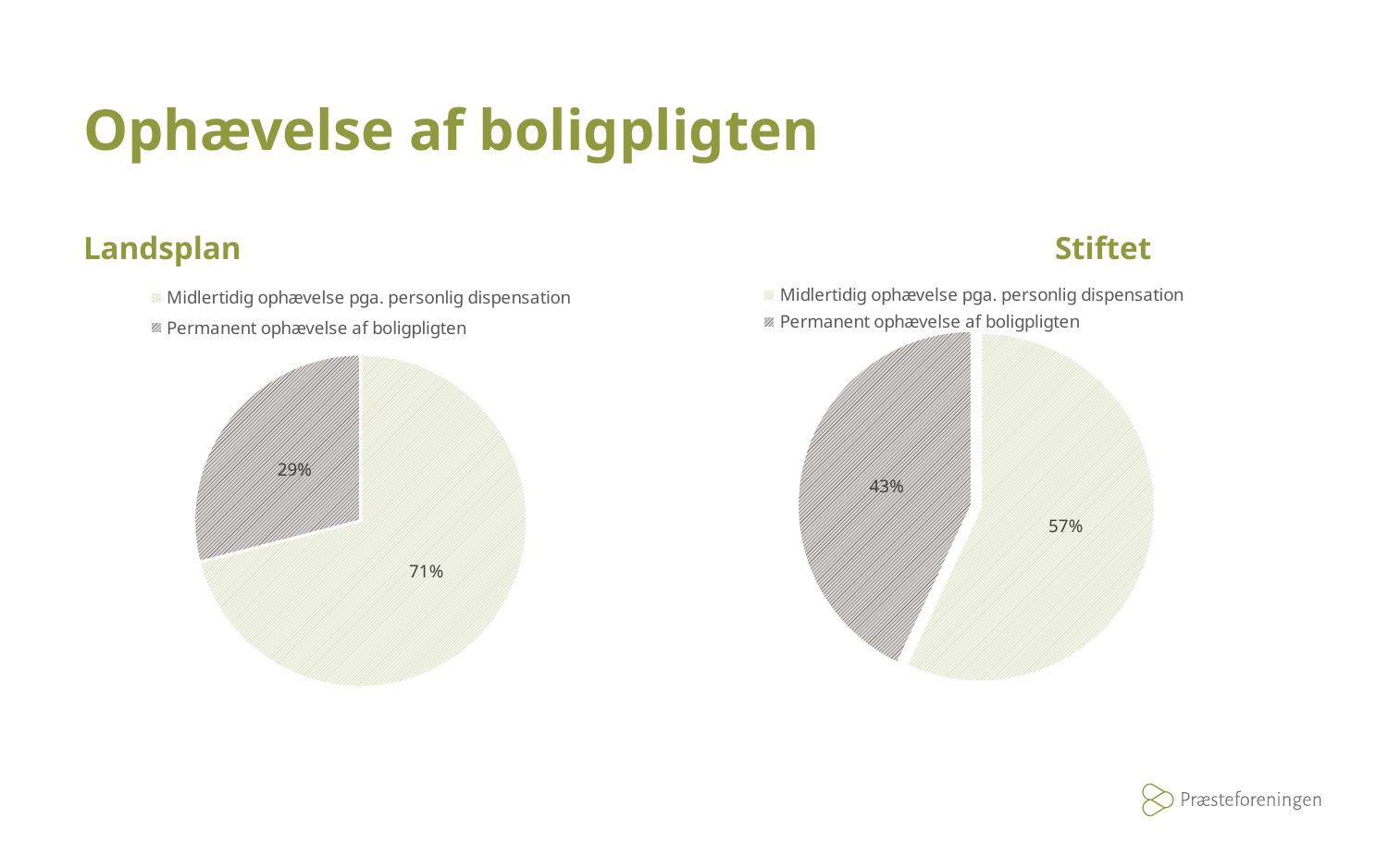
In the Landsplan chart, what is the difference in percentage points between the two slices? 42 In the Stiftet chart, what is the difference in percentage points between the two slices? 14 Is the share of Permanent ophævelse af boligpligten larger in the Landsplan chart or the Stiftet chart? Stiftet In the Landsplan chart, what share is Permanent ophævelse af boligpligten? 29% In the Stiftet chart, what share is Midlertidig ophævelse pga. personlig dispensation? 57% In the Stiftet chart, which category has the smallest slice? Permanent ophævelse af boligpligten In the Landsplan chart, what share is Midlertidig ophævelse pga. personlig dispensation? 71% In the Landsplan chart, which category has the largest slice? Midlertidig ophævelse pga. personlig dispensation In the Stiftet chart, what share is Permanent ophævelse af boligpligten? 43% How many entries does the legend of the Landsplan chart list? 2 What kind of chart is the Landsplan chart? Pie chart How many slices does the Stiftet chart have? 2